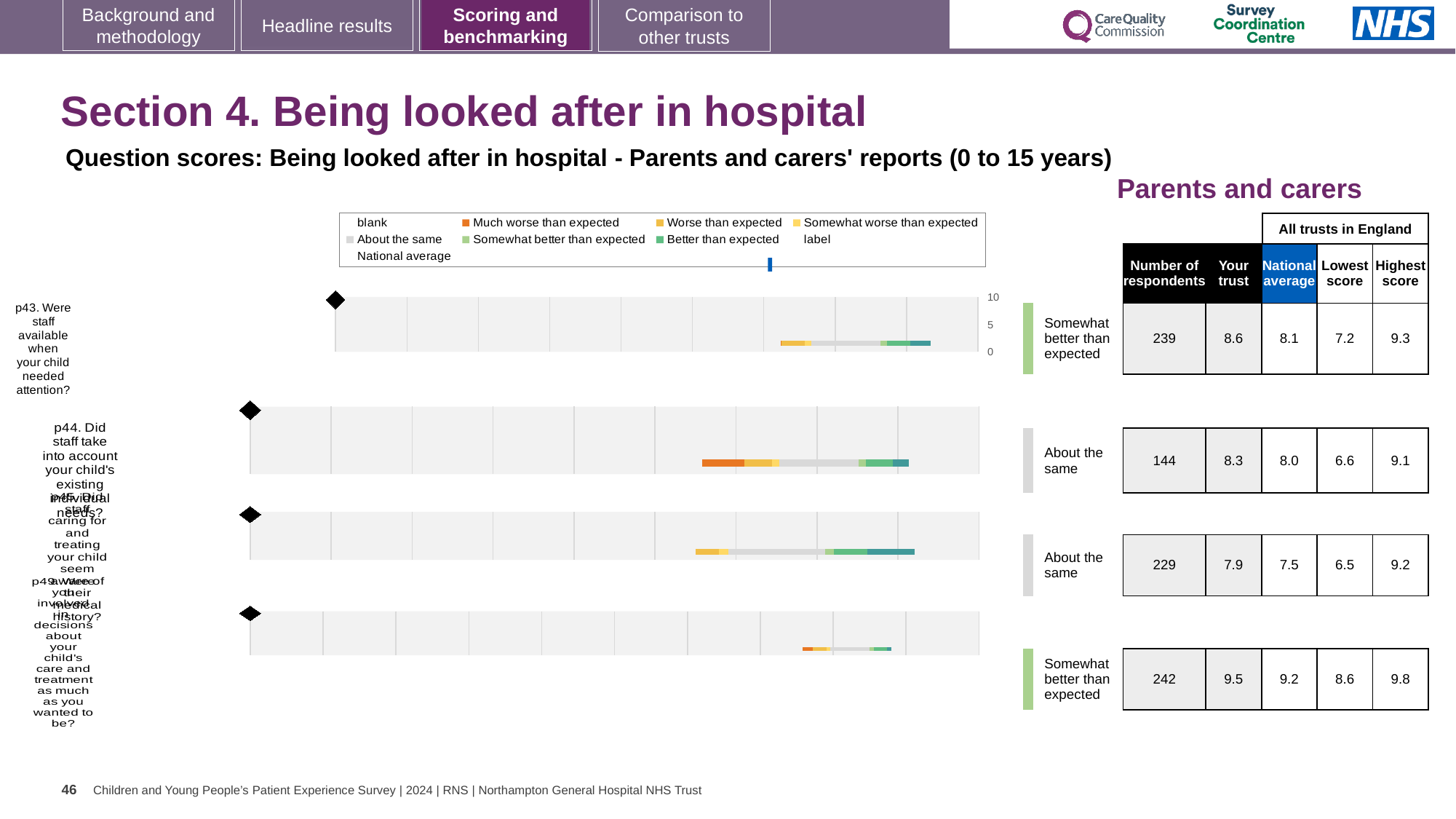
What is the national average score for p43 (Were staff available when your child needed attention?)? 8.1 Which chart row has the highest 'Your trust' score? the bottom (fourth) row, 9.5 What is the 'Your trust' score for p43 (Were staff available when your child needed attention?)? 8.6 What is the highest score among all trusts in England for the bottom (fourth) chart? 9.8 For p43, which is higher: the 'Your trust' score or the national average? Your trust How many question charts are shown on the slide? 4 What is the lowest score among all trusts in England for the second chart from the top? 6.6 What benchmark category is shown for p43 (Were staff available when your child needed attention?)? Somewhat better than expected What is the difference between the 'Your trust' score and the national average for p43? 0.5 Which colour in the legend represents 'Much worse than expected'? orange How many respondents answered p43 (Were staff available when your child needed attention?)? 239 What kind of chart is used for the p43 question on this slide? bar chart